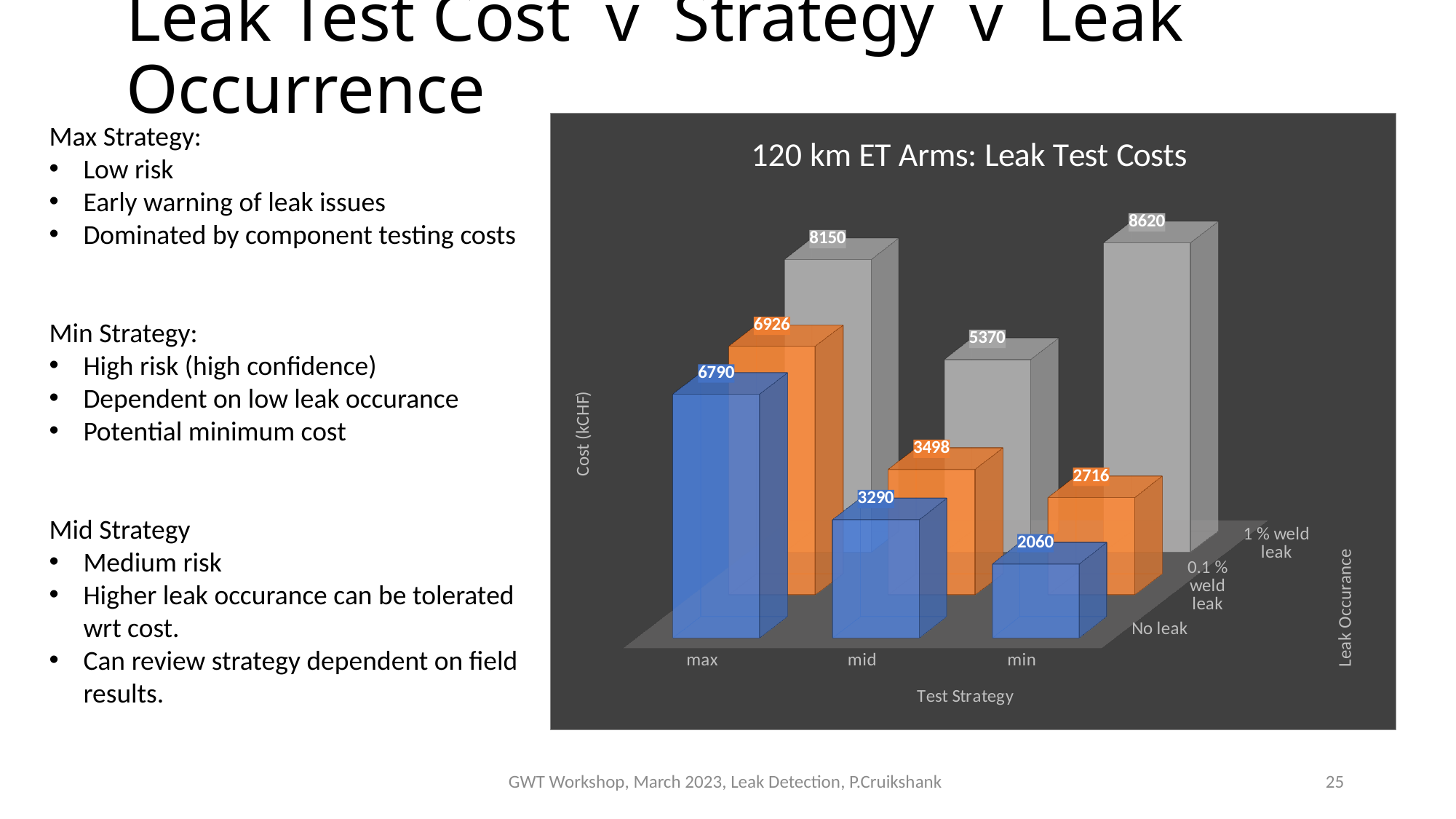
How many leak occurrence categories are plotted? 3 Which test strategy has the highest cost in the 1 % weld leak case? min What is the title of the chart? 120 km ET Arms: Leak Test Costs What is the difference between the 1 % weld leak cost and the no leak cost for the min strategy? 6560 What is the cost for the max test strategy with no leak? 6790 How many test strategies are shown on the Test Strategy axis? 3 What is the label of the vertical axis? Cost (kCHF) Which test strategy has the lowest cost in the no leak case? min What is the cost for the min test strategy with a 1 % weld leak? 8620 What kind of chart is shown on the slide? bar chart Which is larger: the 0.1 % weld leak cost for the max strategy or the 1 % weld leak cost for the mid strategy? max strategy 0.1 % weld leak (6926) What is the cost for the mid test strategy with a 0.1 % weld leak? 3498